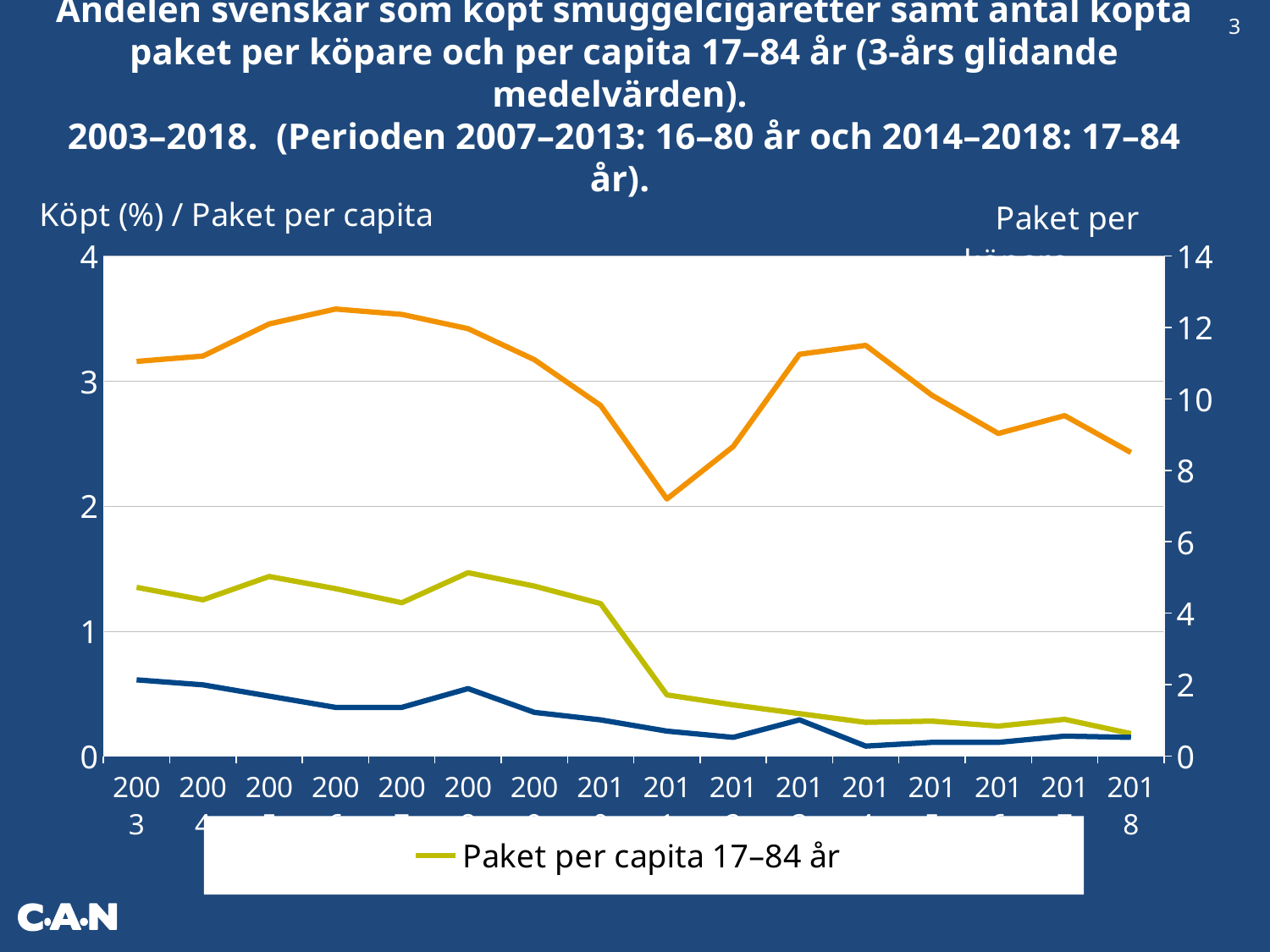
Is the value of the orange line in 2011, read on the right axis, greater or less than 8? less Is the value of the green line (Paket per capita 17–84 år) in 2003 greater or less than 1? greater Which series name is shown in the legend? Paket per capita 17–84 år Is the value of the green line (Paket per capita 17–84 år) in 2018 greater or less than 1? less In 2003, which line is higher on the left axis: the green line or the blue line? the green line In which year does the orange line reach its lowest value? 2011 What kind of chart is shown on the slide? line chart What is the highest tick value on the right-hand axis? 14 Does the green line (Paket per capita 17–84 år) rise or fall from 2003 to 2018? fall How many years are plotted along the x axis? 16